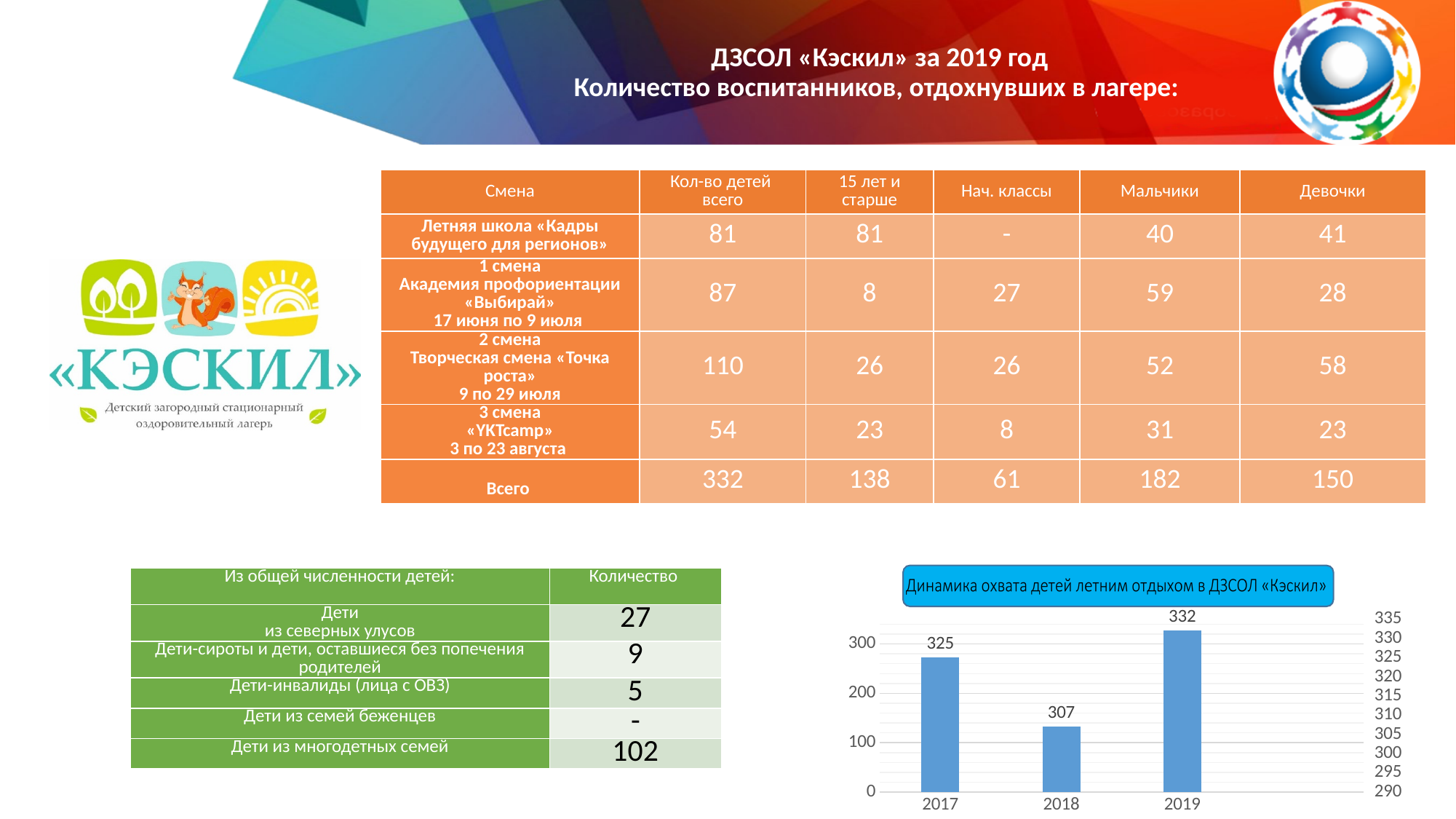
What is the value for 2018 in the chart? 307 How many years (bars) are shown in the chart? 3 What is the value for 2019 in the chart? 332 Which year has the lowest value in the chart? 2018 What is the title of the chart? Динамика охвата детей летним отдыхом в ДЗСОЛ «Кэскил» What type of chart is shown on the slide? bar chart Which is larger, the value for 2017 or the value for 2019? 2019 Which year has the highest value in the chart? 2019 What is the value for 2017 in the chart? 325 What is the difference between the values for 2019 and 2018? 25 Does the value rise or fall from 2018 to 2019? rise What is the difference between the values for 2017 and 2018? 18